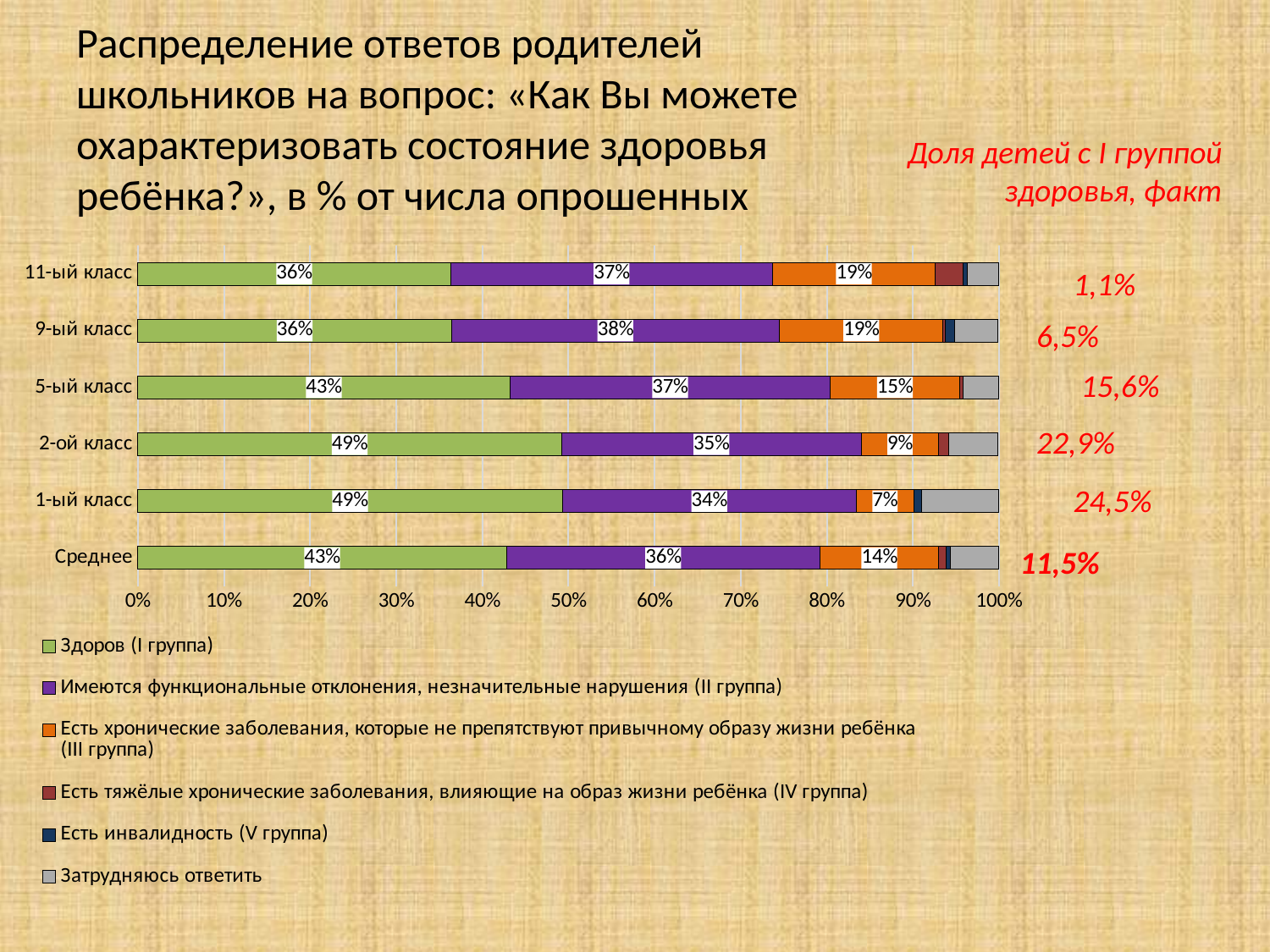
What is the value for Здоров (I группа) for 5-ый класс? 43% What is the value for Есть хронические заболевания (III группа) for Среднее? 14% What is the difference between the Здоров (I группа) values for 2-ой класс and 11-ый класс? 13 percentage points What is the value for Есть хронические заболевания (III группа) for 9-ый класс? 19% Which has a larger value for Имеются функциональные отклонения (II группа): 5-ый класс or 1-ый класс? 5-ый класс Which category has the highest value for Имеются функциональные отклонения (II группа)? 9-ый класс How many categories are shown on the chart? 6 Is the value for Затрудняюсь ответить for 1-ый класс greater or less than 5%? greater What kind of chart is shown on the slide? Stacked bar chart Which category has the lowest value for Есть хронические заболевания (III группа)? 1-ый класс What is the value for Имеются функциональные отклонения, незначительные нарушения (II группа) for 1-ый класс? 34% How many series does the legend list? 6